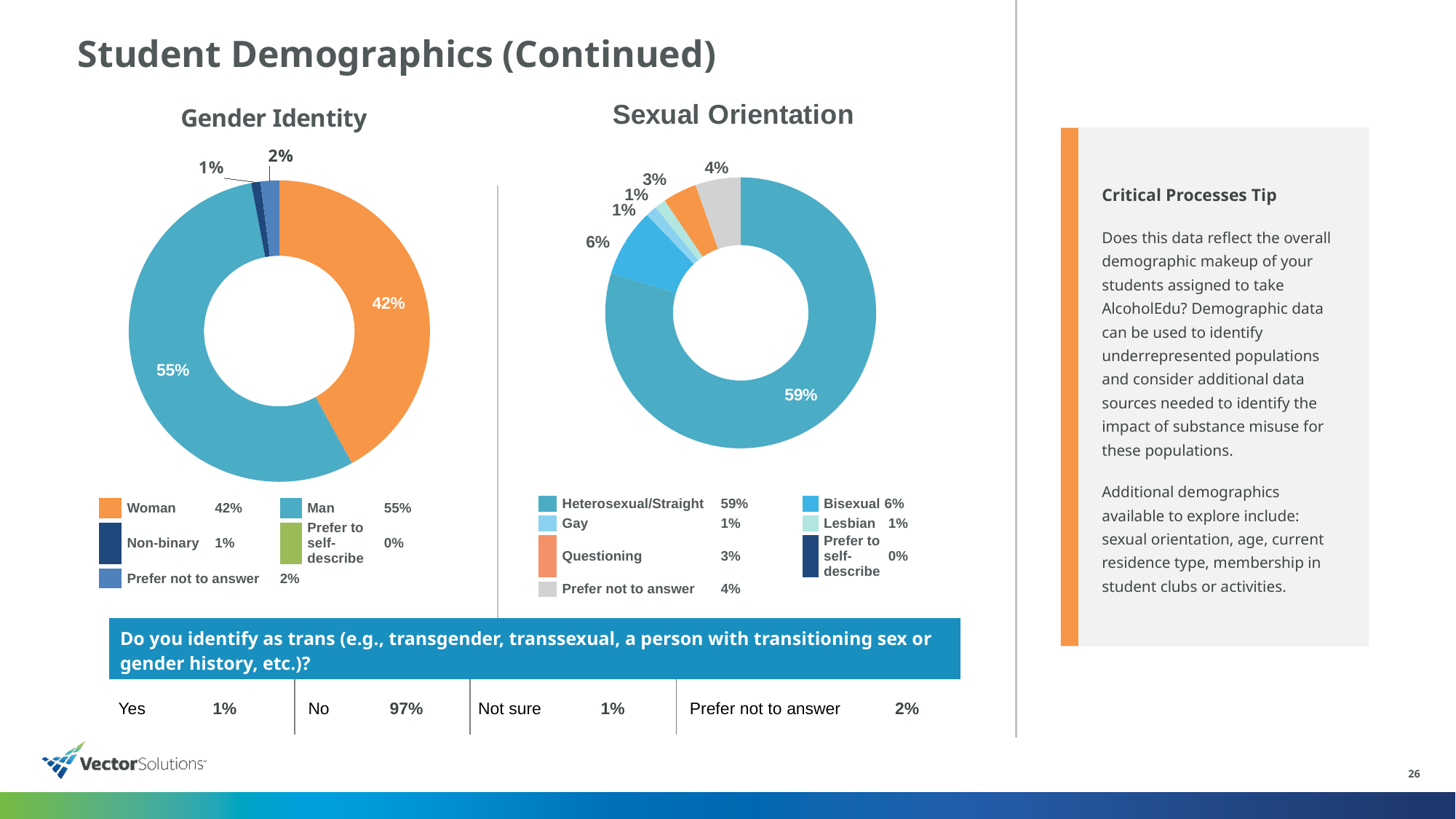
How many categories does the Sexual Orientation chart's legend list? 7 In the Gender Identity chart, what is the difference between the Man and Woman shares? 13% In the Gender Identity chart, which category has the largest share? Man In the Gender Identity chart, what percentage chose Prefer not to answer? 2% How many categories does the Gender Identity chart's legend list? 5 In the Sexual Orientation chart, which is larger, Questioning or Prefer not to answer? Prefer not to answer In the Sexual Orientation chart, what percentage of students identify as Bisexual? 6% In the Gender Identity chart, what percentage of students identify as Woman? 42% What kind of chart is used for Sexual Orientation? Doughnut chart In the Sexual Orientation chart, what percentage of students identify as Heterosexual/Straight? 59% In the Gender Identity chart, what colour represents Woman? Orange In the Sexual Orientation chart, what is the difference between the Bisexual and Questioning shares? 3%